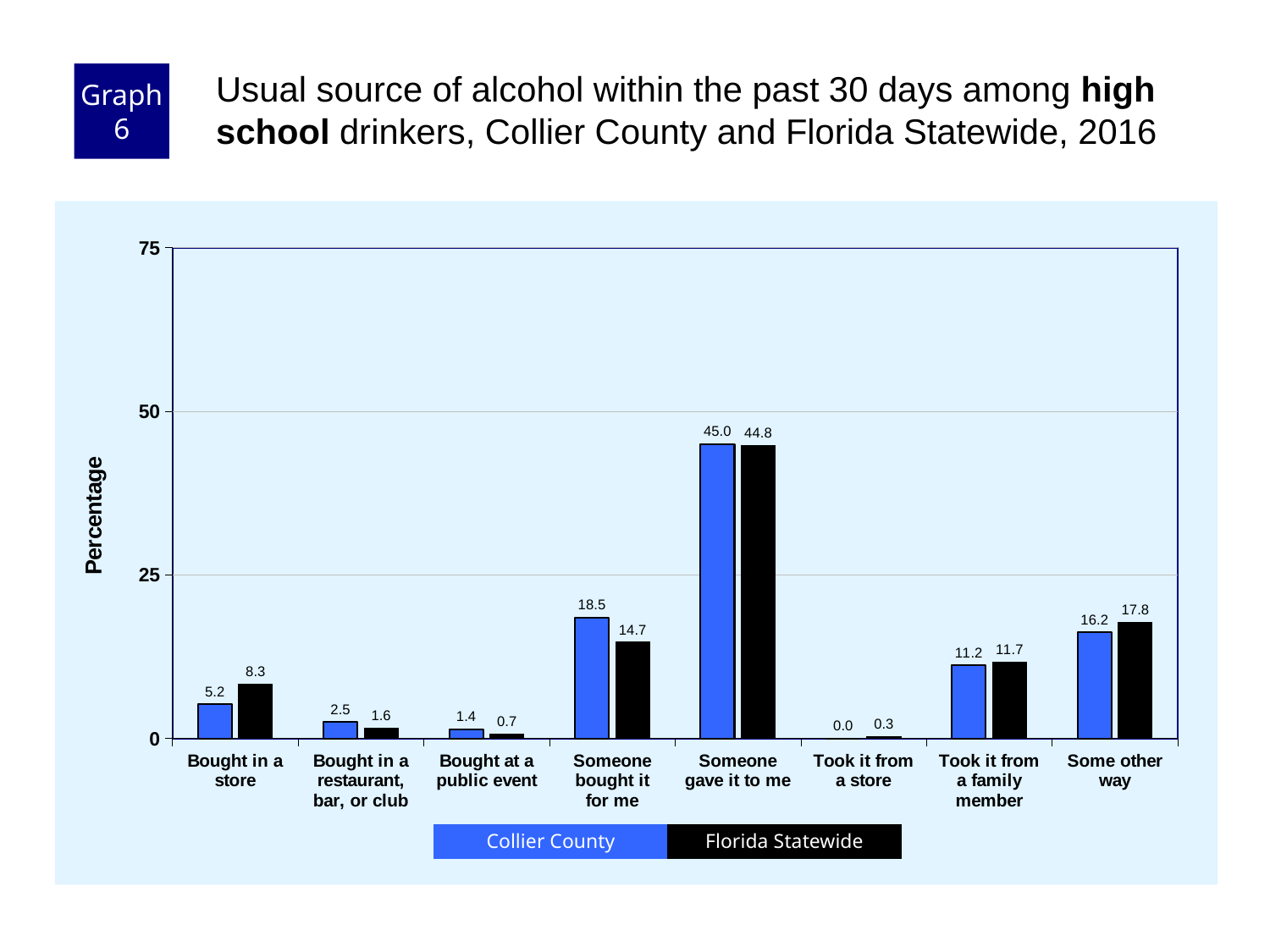
What is the difference between the Collier County and Florida Statewide values for "Someone bought it for me"? 3.8 Which is larger for "Some other way": Collier County or Florida Statewide? Florida Statewide What is the Florida Statewide value for "Bought in a store"? 8.3 What kind of chart is shown on the slide? Bar chart Which category has the lowest Collier County value? Took it from a store What is the Collier County value for "Someone gave it to me"? 45.0 How many series does the legend list? 2 What is the label of the y axis? Percentage Is the Collier County value for "Someone gave it to me" greater or less than 25? greater How many categories are shown on the x axis? 8 What is the Collier County value for "Took it from a family member"? 11.2 Which category has the highest Florida Statewide value? Someone gave it to me